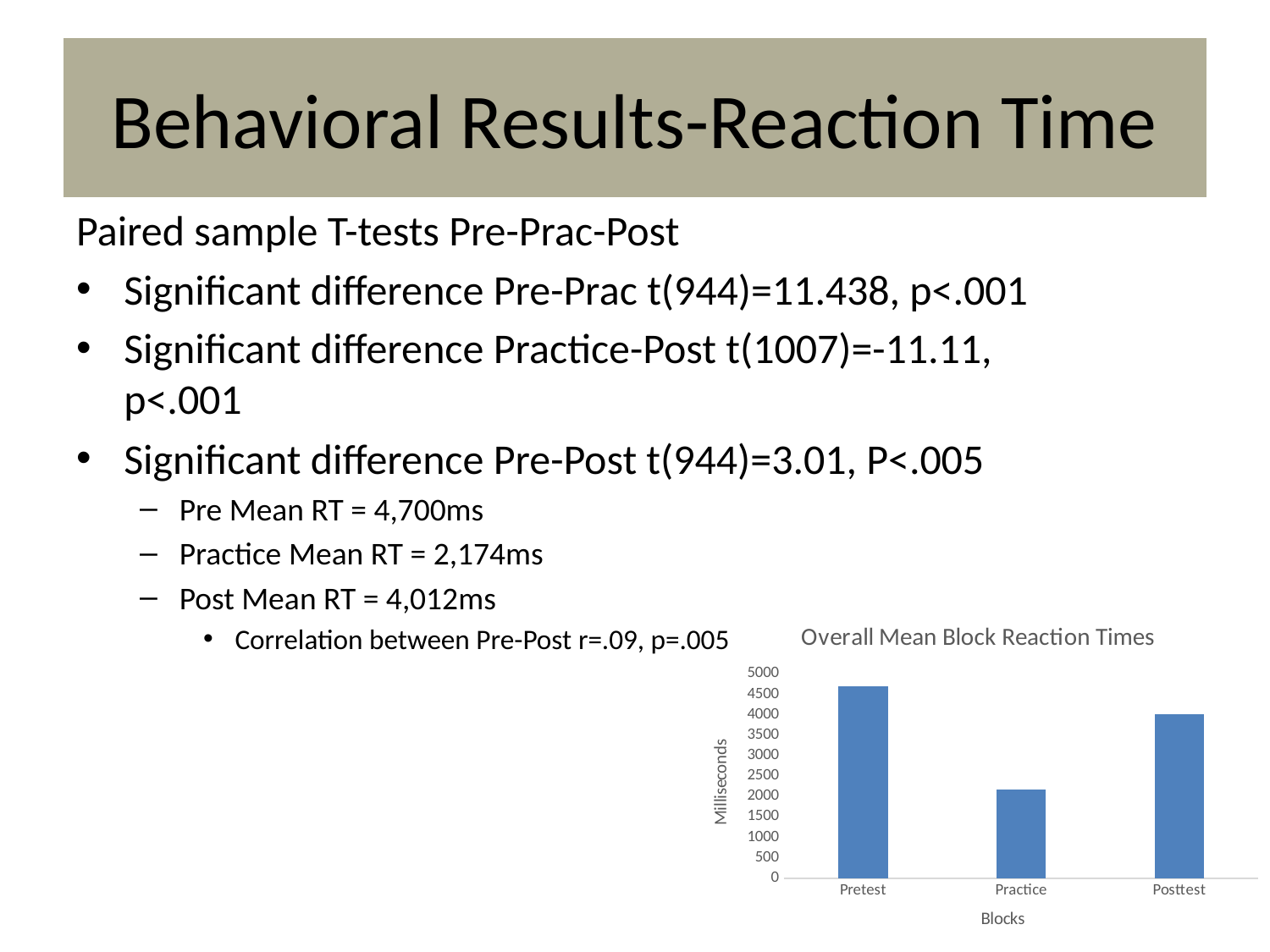
Which is larger in the chart, the value for Pretest or the value for Posttest? Pretest What is the title of the chart? Overall Mean Block Reaction Times Is the value for Posttest greater or less than 3500? greater Which block has the highest mean reaction time in the chart? Pretest Is the value for Practice greater or less than 2500? less Which is larger in the chart, the value for Practice or the value for Posttest? Posttest What kind of chart is shown on the slide? bar chart Which block has the lowest mean reaction time in the chart? Practice What is the label of the vertical axis of the chart? Milliseconds How many blocks (categories) are plotted in the chart? 3 Do the values in the chart rise or fall from Pretest to Practice? fall Is the value for Pretest greater or less than 4500? greater